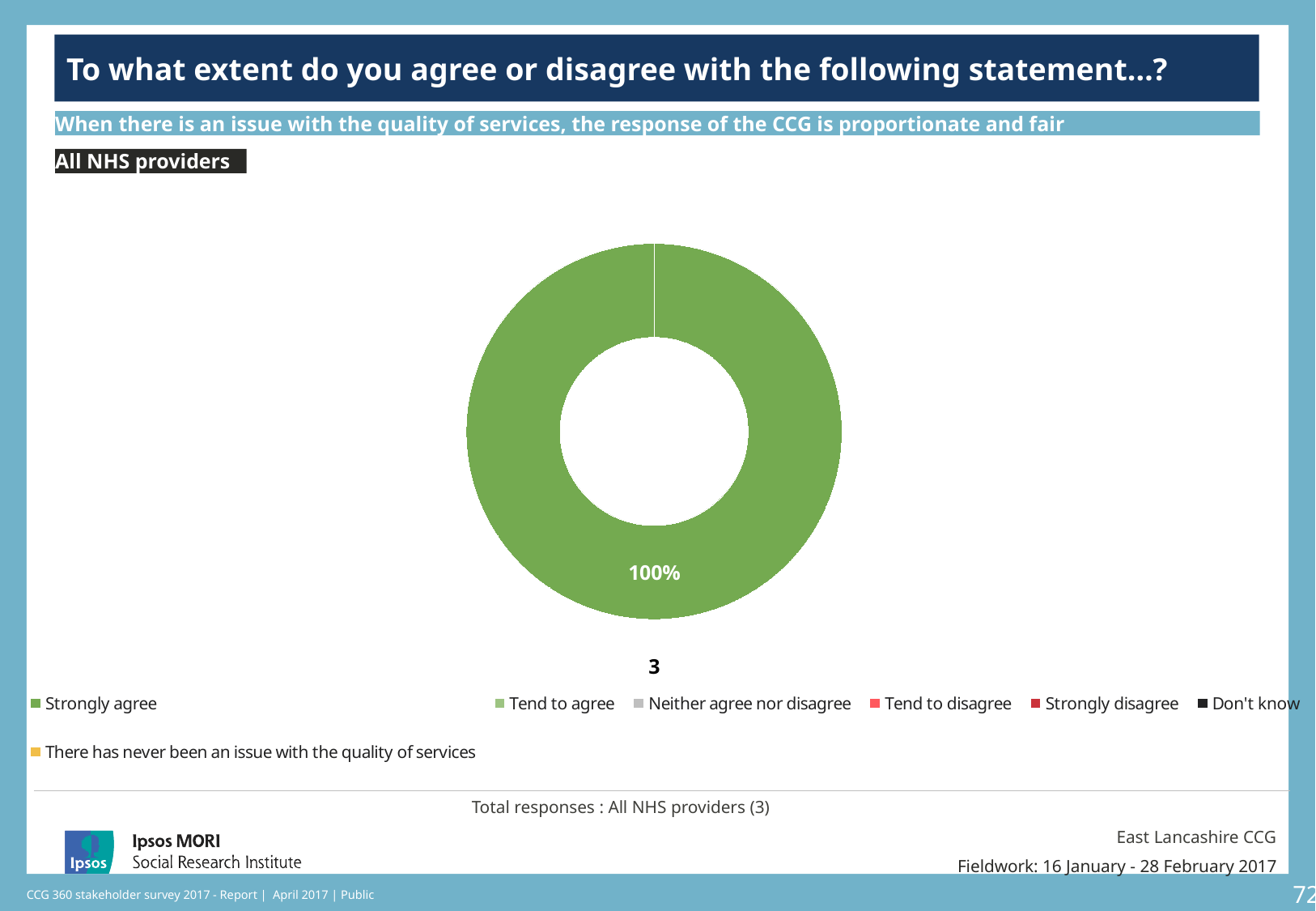
What is the total number of responses from All NHS providers stated on the slide? 3 How many slices does the pie chart contain? 1 Which respondent group does the chart cover, according to the label above it? All NHS providers What kind of chart is shown on the slide? pie chart (donut) What percentage value is printed on the chart? 100% Which response category does the green slice filling the whole chart represent? Strongly agree How many response categories does the legend list? 7 What share of the pie does the single green slice take up? 100% What statement is the chart about, as shown in the subtitle bar? When there is an issue with the quality of services, the response of the CCG is proportionate and fair Is the value shown on the chart greater or less than 50%? greater What number is printed directly below the chart? 3